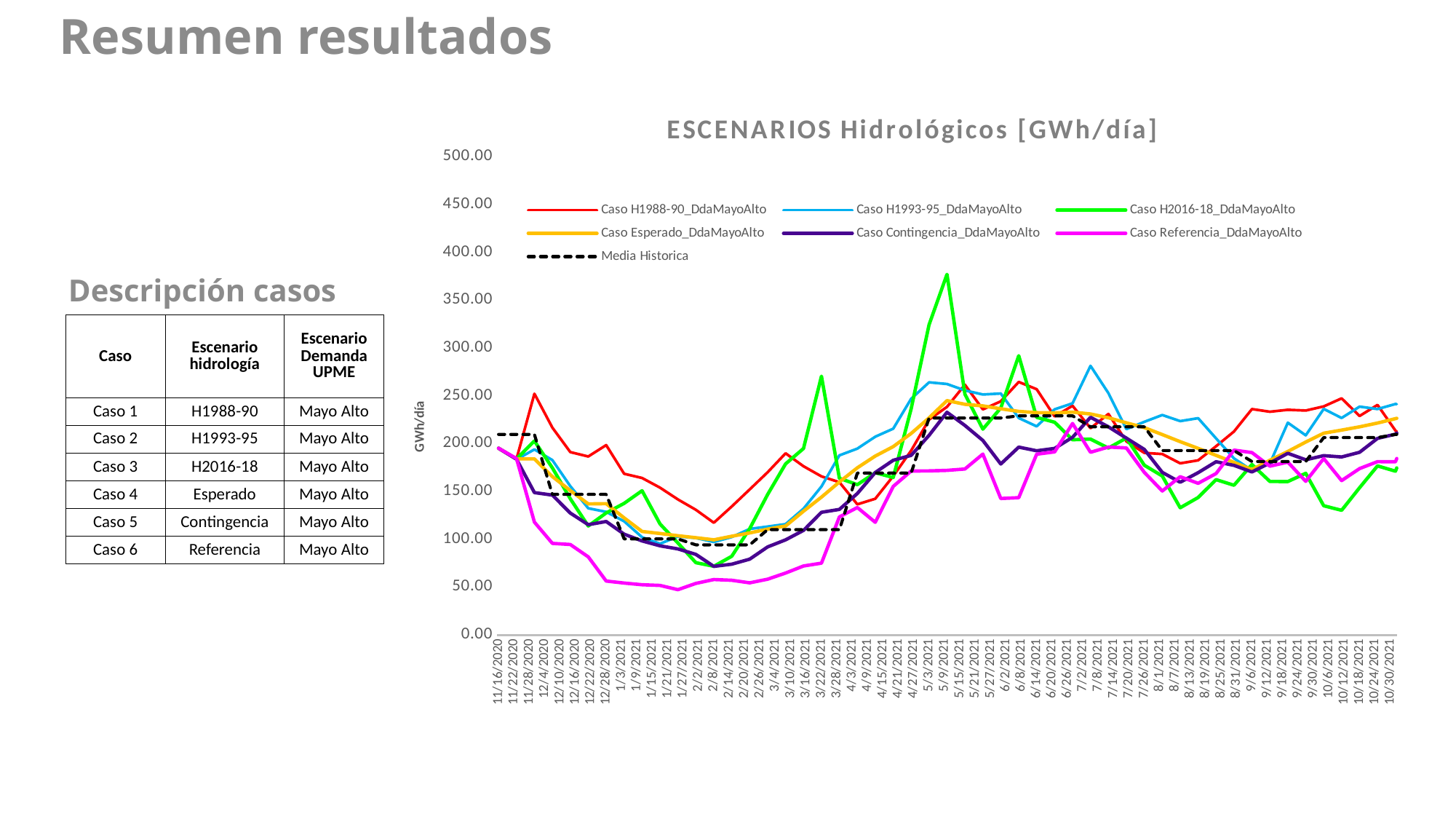
Which series has the lowest values during January 2021? Caso Referencia_DdaMayoAlto On 5/9/2021, which is larger: Caso H2016-18_DdaMayoAlto or Caso Referencia_DdaMayoAlto? Caso H2016-18_DdaMayoAlto What kind of chart is shown on the slide? line chart Which series reaches the highest peak value in the chart? Caso H2016-18_DdaMayoAlto What is the title of the chart? ESCENARIOS Hidrológicos [GWh/día] Is the value for Media Historica on 1/27/2021 greater or less than 150? less Is the peak value of Caso H2016-18_DdaMayoAlto greater or less than 350? greater How many series does the legend of the chart list? 7 Which series is drawn as a dashed line in the chart? Media Historica Is the value for Caso Referencia_DdaMayoAlto on 1/27/2021 greater or less than 100? less Between 11/28/2020 and 1/27/2021, does the Caso H1988-90_DdaMayoAlto line rise or fall? fall